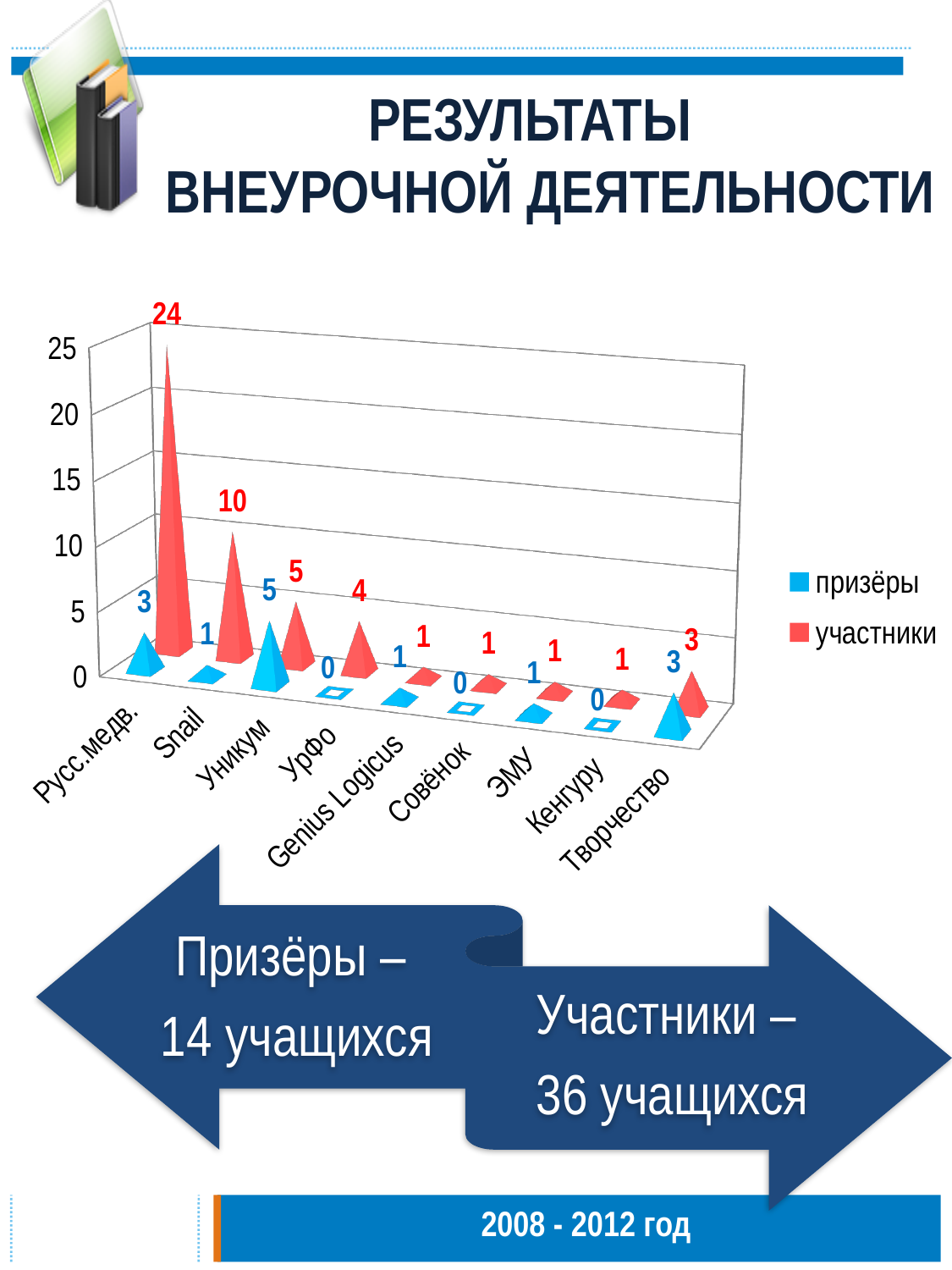
What is the difference between участники and призёры for Snail? 9 Which colour represents the участники series? red How many участники are shown for Snail? 10 Which category has the highest number of призёры? Уникум What kind of chart is shown on the slide? bar chart How many series does the legend list? 2 What is the value of призёры for Творчество? 3 Which category has the highest number of участники? Русс.медв. How many участники are shown for Русс.медв.? 24 What is the value of призёры for Уникум? 5 Which is larger for УрФо: призёры or участники? участники How many categories are shown on the x axis? 9